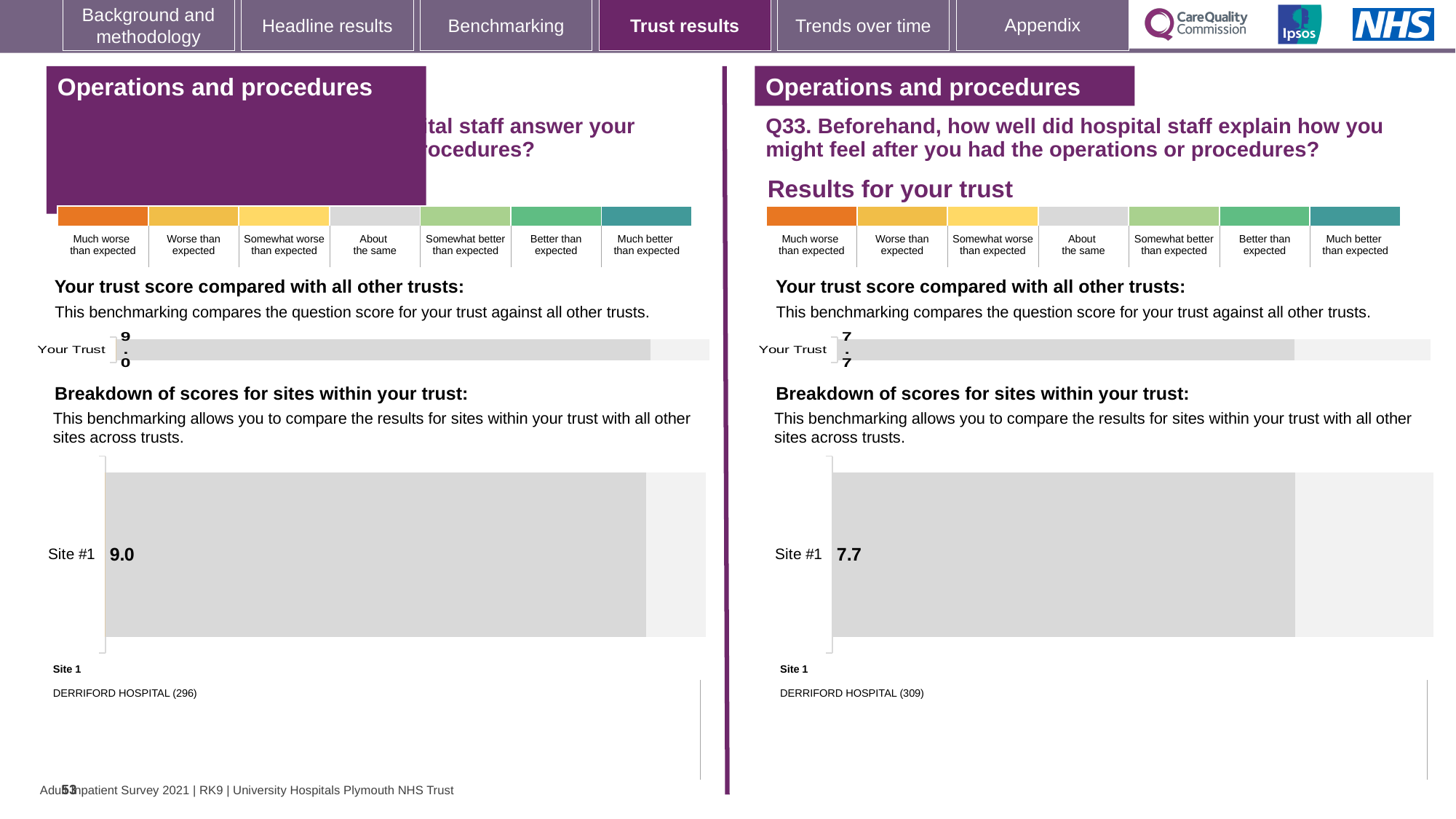
How many sites are plotted in the 'Breakdown of scores for sites within your trust' chart on the right half of the slide (Q33)? 1 What type of chart is used to show the Site #1 score on the right half of the slide (Q33)? Bar chart Which is larger: the Site #1 score on the left half of the slide or the Site #1 score on the right half (Q33)? Left half (9.0) On the left half of the slide, what is the score shown for Your Trust in the 'Your trust score compared with all other trusts' chart? 9.0 On the right half of the slide (Q33), which hospital is listed as Site 1 below the site breakdown chart? DERRIFORD HOSPITAL (309) How many sites are plotted in the 'Breakdown of scores for sites within your trust' chart on the left half of the slide? 1 What is the difference between the Site #1 score on the left half of the slide and the Site #1 score on the right half (Q33)? 1.3 What type of chart is used to show the Your Trust score on the left half of the slide? Bar chart On the right half of the slide (Q33), what is the score shown for Your Trust in the 'Your trust score compared with all other trusts' chart? 7.7 On the left half of the slide, which hospital is listed as Site 1 below the site breakdown chart? DERRIFORD HOSPITAL (296) On the right half of the slide (Q33), what score is shown for Site #1 in the 'Breakdown of scores for sites within your trust' chart? 7.7 On the left half of the slide, what score is shown for Site #1 in the 'Breakdown of scores for sites within your trust' chart? 9.0